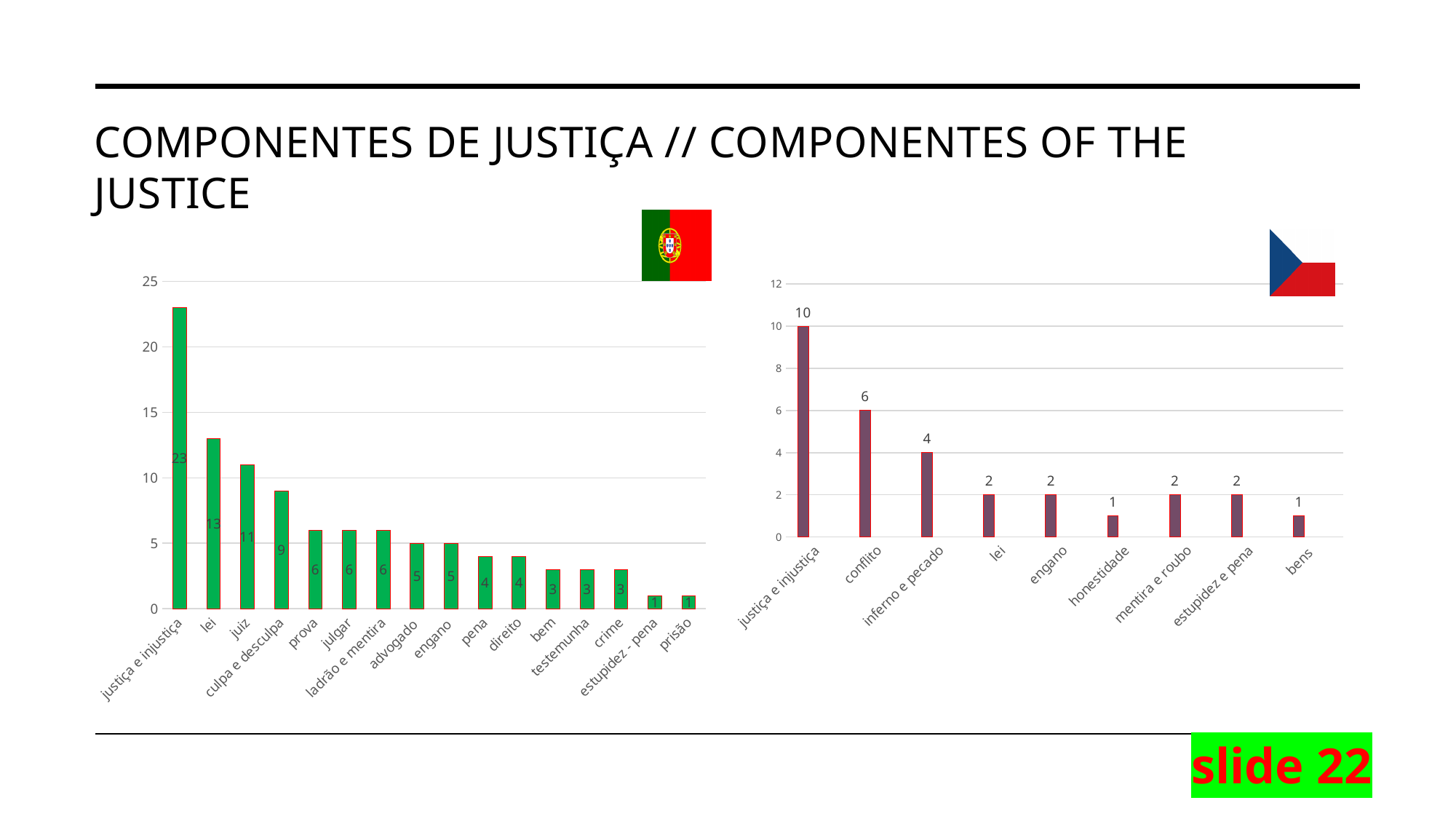
In the right chart, how many categories are shown on the x axis? 9 In the right chart, what is the value for 'inferno e pecado'? 4 In the right chart, which category has the highest value? justiça e injustiça What kind of chart is the left chart? bar chart In the left chart, how many categories are shown on the x axis? 16 In the left chart, what is the value for 'culpa e desculpa'? 9 In the right chart, which is larger, the value for 'conflito' or the value for 'lei'? conflito In the left chart, which category has the highest value? justiça e injustiça In the left chart, what is the difference between the values for 'justiça e injustiça' and 'lei'? 10 In the left chart, what is the value for 'lei'? 13 In the left chart, is the value for 'juiz' greater or less than 10? greater In the right chart, what is the value for 'conflito'? 6